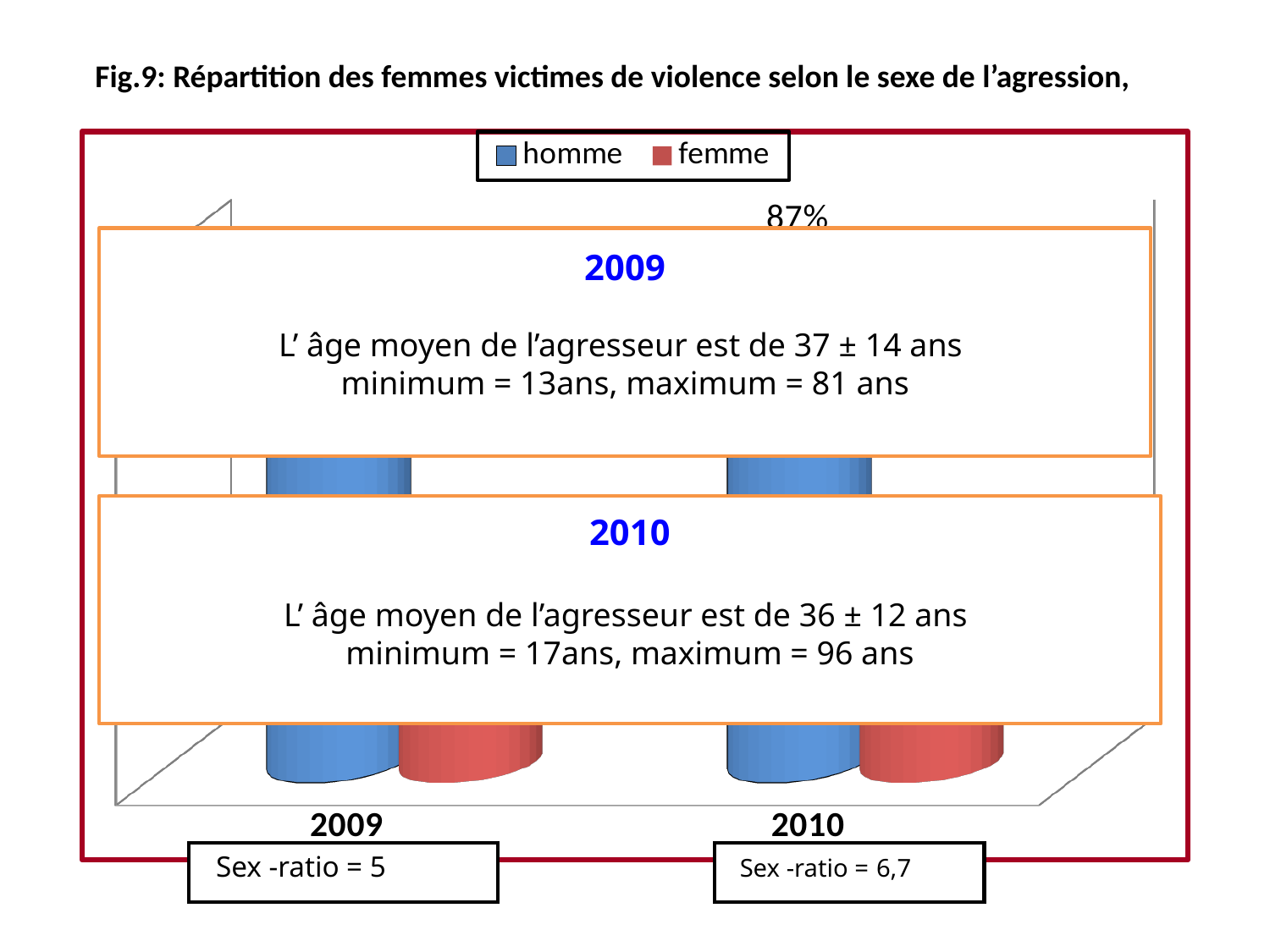
In 2010, which is larger: the value for 'homme' or the value for 'femme'? homme How many categories are shown on the x axis? 2 What are the two series named in the legend? homme and femme Which series has the highest value in 2009? homme Which series has the lowest value in 2010? femme What are the category labels on the x axis? 2009 and 2010 Which colour represents the 'femme' series? red How many series does the legend list? 2 In 2009, which is larger: the value for 'homme' or the value for 'femme'? homme What is the value shown for 'homme' in 2010? 87% What kind of chart is shown on the slide? bar chart